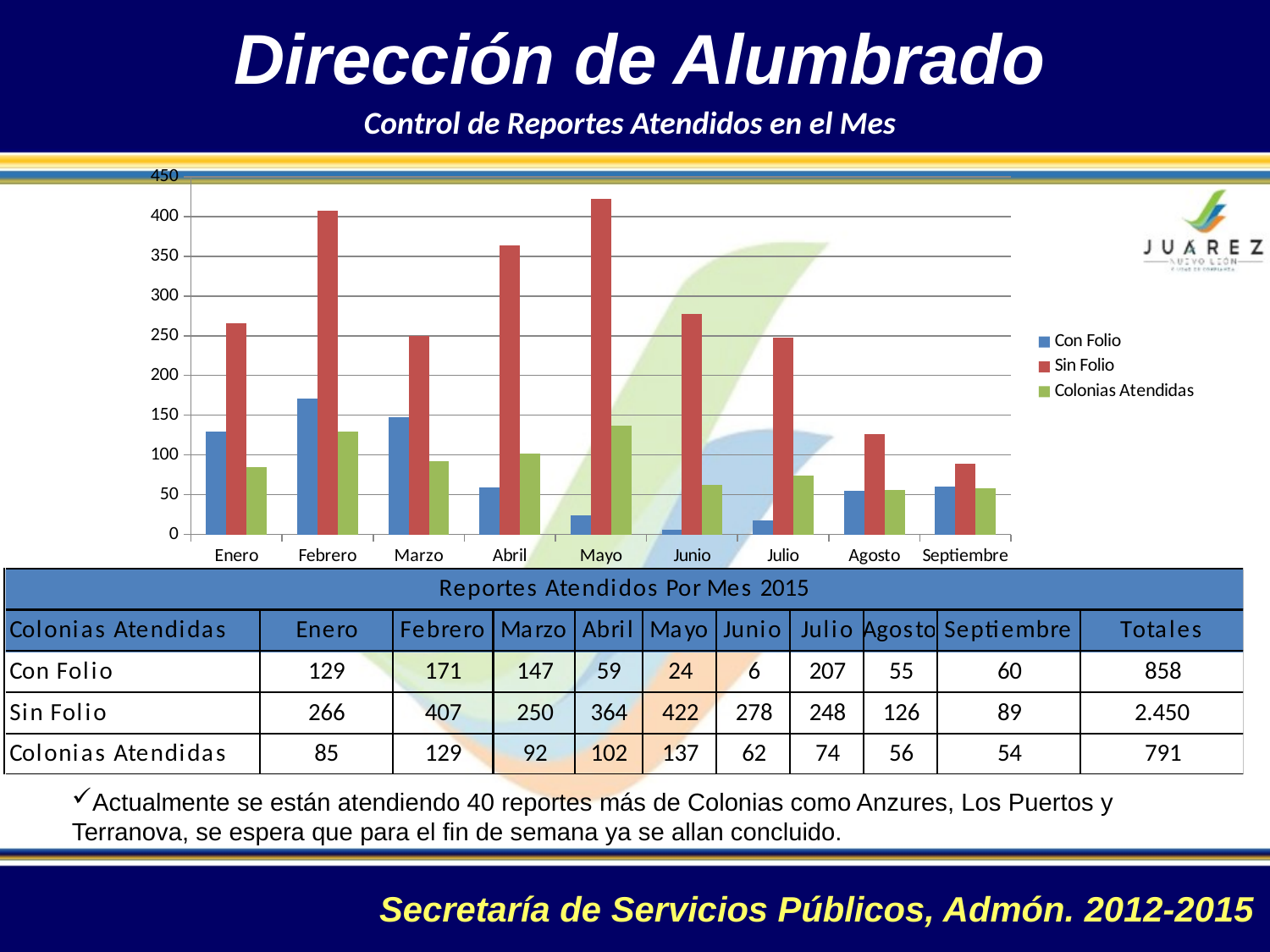
What is the difference between the Sin Folio and Con Folio values for Febrero? 236 Which is larger in Marzo, Con Folio or Colonias Atendidas? Con Folio What kind of chart is shown on the slide? bar chart How many series does the chart legend list? 3 In which month is the Con Folio value lowest? Junio Which series is shown in red in the chart? Sin Folio Is the Sin Folio value for Abril greater or less than 350? greater How many months are shown on the x axis of the chart? 9 What is the Sin Folio value for Mayo? 422 In which month is the Sin Folio value highest? Mayo What is the Colonias Atendidas value for Febrero? 129